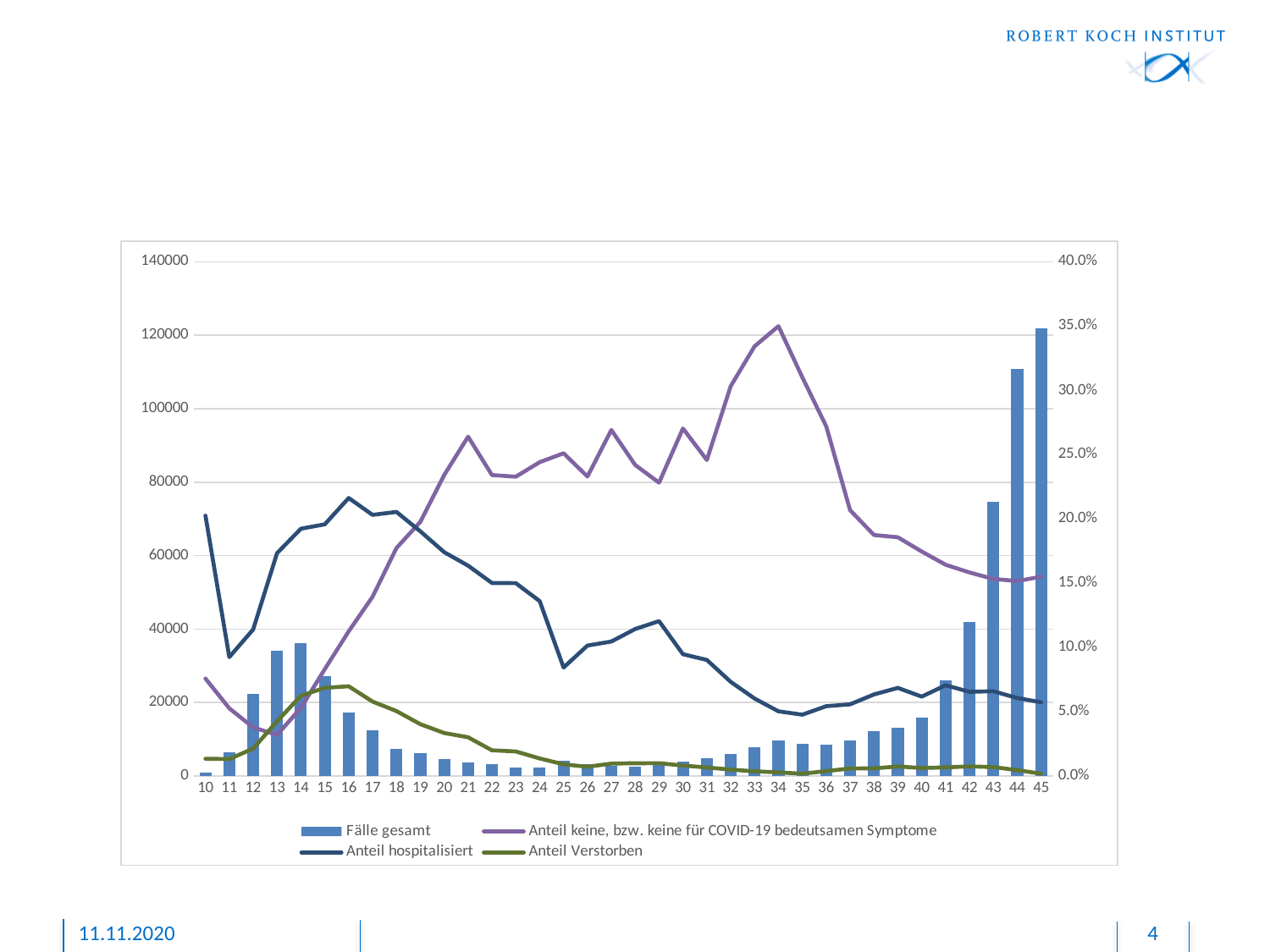
Is the peak of the line 'Anteil keine, bzw. keine für COVID-19 bedeutsamen Symptome' around week 34 greater or less than 30.0%? greater How many calendar weeks are shown on the x axis? 36 Is the value of Anteil Verstorben in week 16 greater or less than 5.0%? greater Which is larger, Anteil hospitalisiert in week 16 or in week 45? week 16 How many series does the legend list? 4 What kind of chart is this? A combined bar and line chart Which is larger, Fälle gesamt in week 44 or in week 43? week 44 Do the bars for Fälle gesamt rise or fall from week 36 to week 45? rise In which week is the bar for Fälle gesamt highest? 45 Is the value of Fälle gesamt in week 43 greater or less than 80000? less In which week is the bar for Fälle gesamt lowest? 10